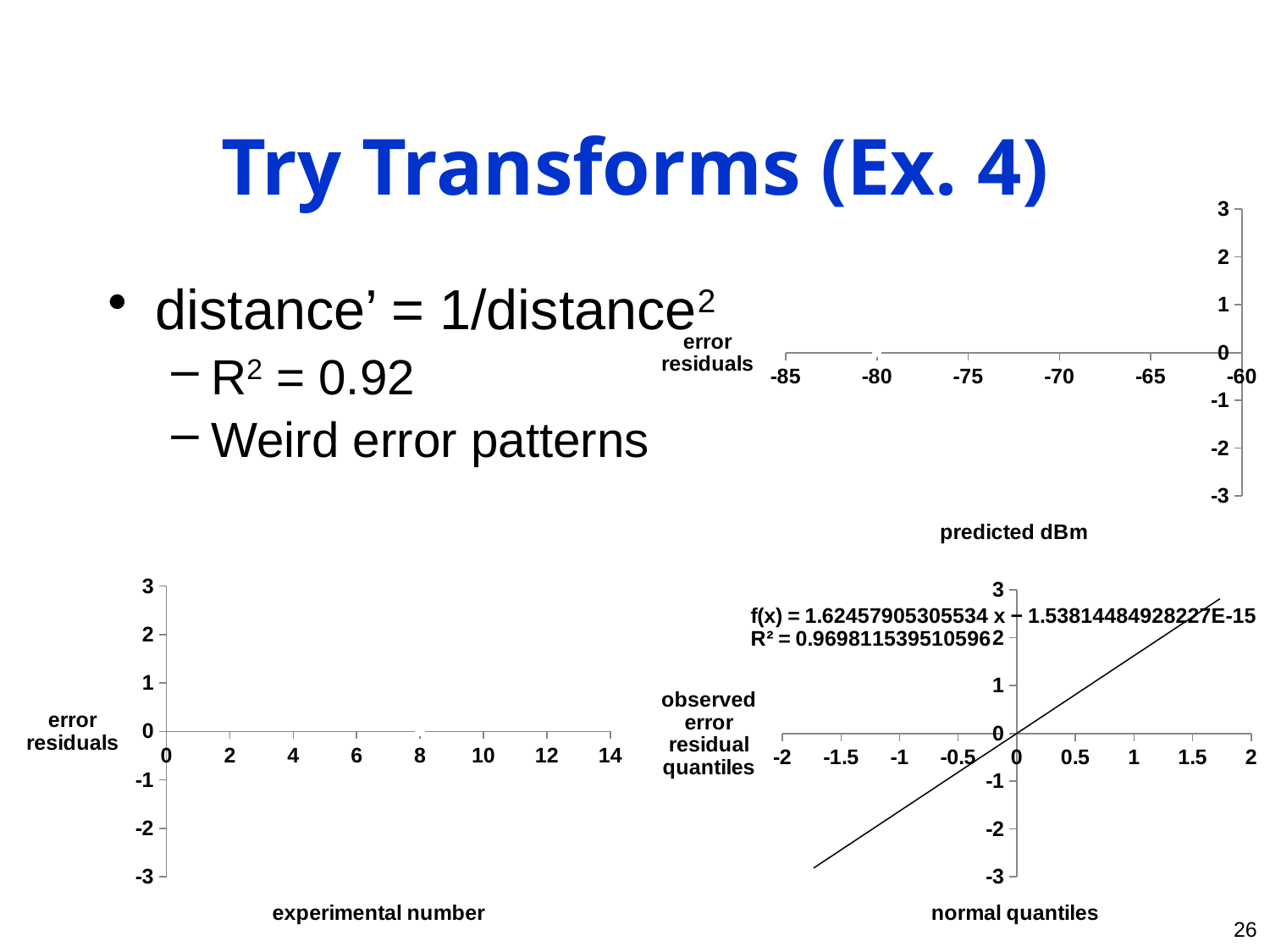
What R² value is printed on the bottom-right chart (normal quantiles)? 0.969811539510596 In the bottom-right chart (normal quantiles), is the fitted line's value at x = 1 greater or less than 1? greater What is the x-axis label of the bottom-left chart? experimental number In the bottom-right chart (normal quantiles), is the fitted line's value at x = -1 greater or less than -1? less What is the slope of the fitted line f(x) printed on the bottom-right chart (normal quantiles)? 1.62457905305534 What kind of chart is the bottom-right chart with the x axis labelled 'normal quantiles'? scatter chart with a fitted line In the bottom-right chart (normal quantiles), does the fitted line rise or fall as the x axis increases? rises What is the x-axis label of the top-right chart? predicted dBm